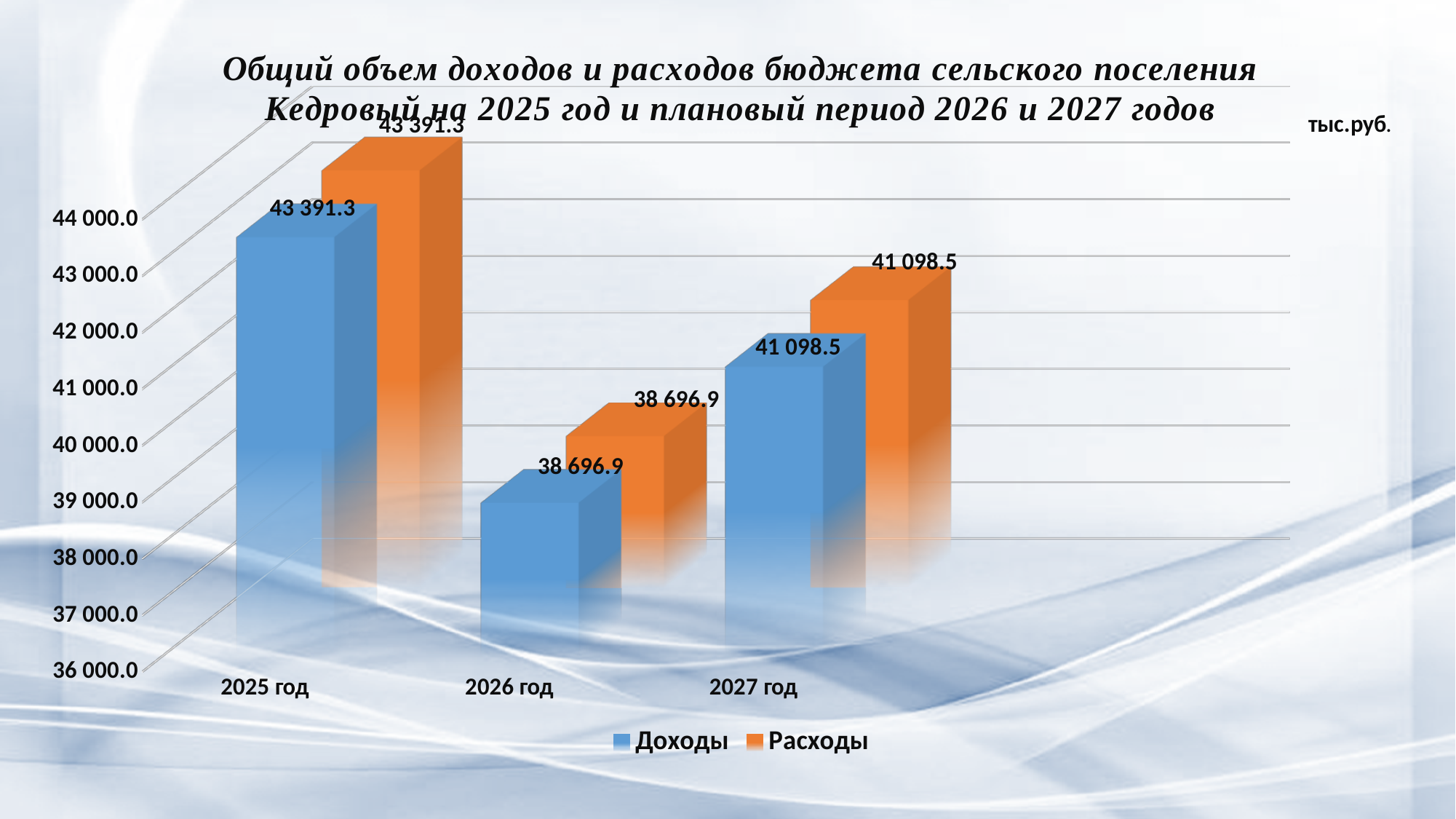
What unit is indicated for the values on the chart? тыс.руб. Which is larger: Доходы for 2027 год or Доходы for 2026 год? Доходы for 2027 год What is the value of Доходы for 2025 год? 43 391.3 How many years are shown on the x axis? 3 What is the value of Расходы for 2026 год? 38 696.9 Which year has the lowest value for Доходы? 2026 год What is the difference between Доходы for 2025 год and Доходы for 2026 год? 4 694.4 How many series does the legend list? 2 Which year has the highest value for Расходы? 2025 год What is the value of Доходы for 2027 год? 41 098.5 What is the difference between Расходы for 2027 год and Расходы for 2026 год? 2 401.6 What kind of chart is shown on the slide? Bar chart